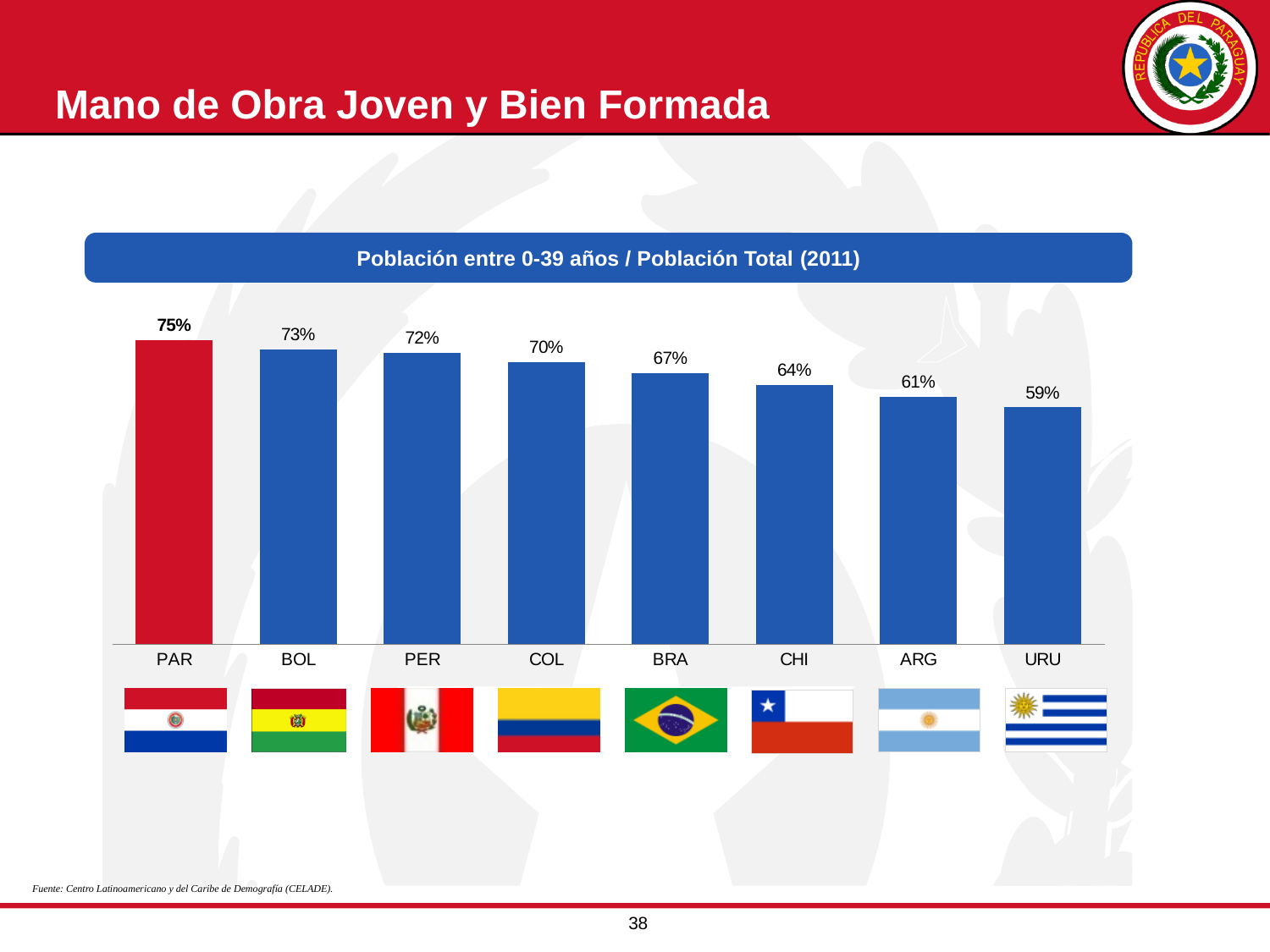
What is the value for PAR? 75% Do the values rise or fall from left to right across the chart? Fall How many countries are shown in the chart? 8 What kind of chart is shown on the slide? Bar chart What is the value for CHI? 64% What is the difference between the values for BOL and COL? 3% What is the value for URU? 59% Which country has the highest value? PAR Which is larger, the value for PER or the value for ARG? PER Which country has the lowest value? URU What is the difference between the values for PAR and URU? 16% What is the value for BRA? 67%